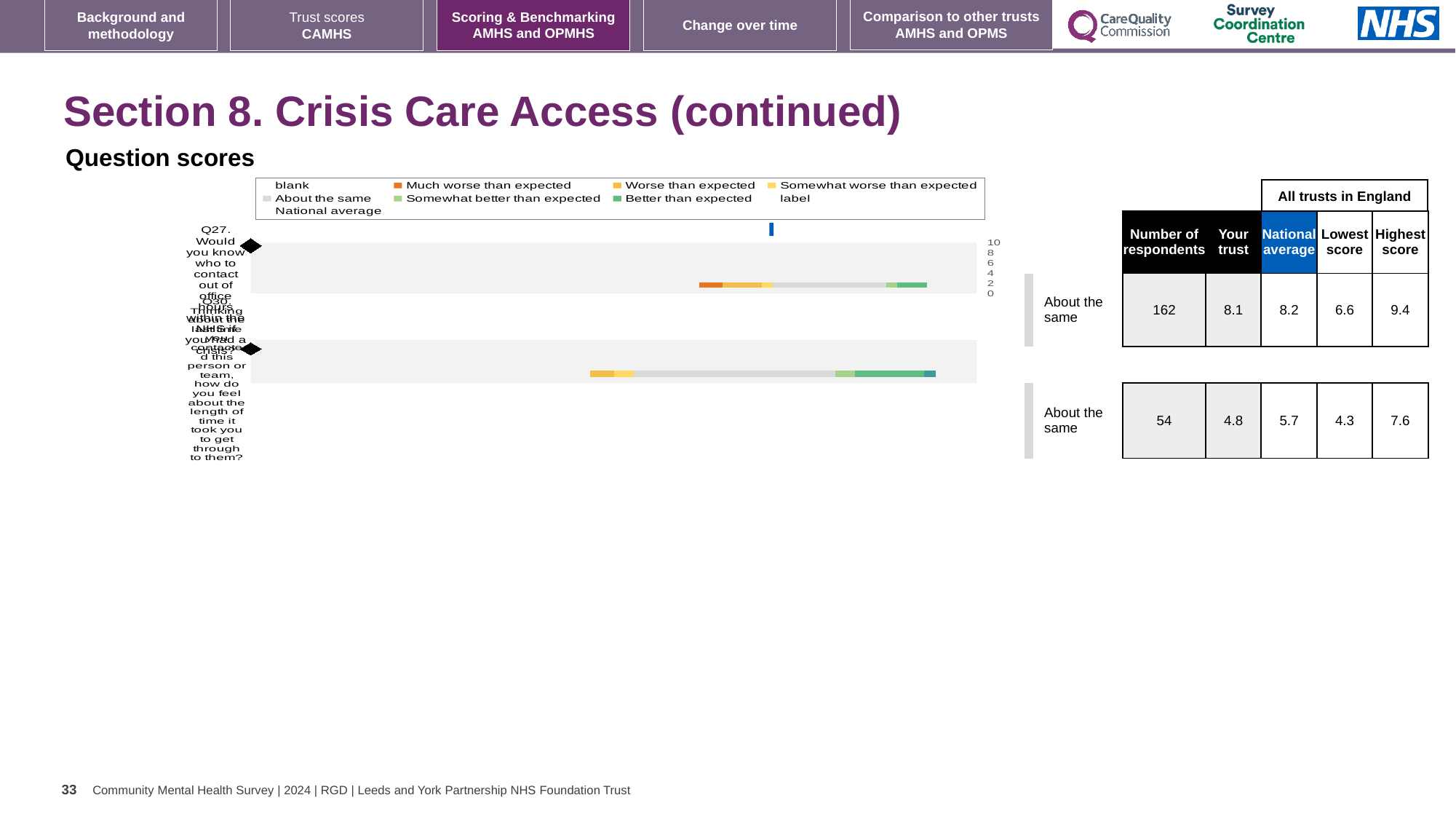
How many questions (bars) are plotted in the Question scores chart? 2 What benchmark category label is shown beside both Q27 and Q30? About the same What is the difference between the national average and the trust's score for Q30? 0.9 In the table next to the chart, what is the national average for Q30 (length of time it took to get through)? 5.7 How many respondents answered Q27 according to the table? 162 What is the lowest score across all trusts in England for Q30? 4.3 Which question has the higher 'Your trust' score, Q27 or Q30? Q27 How many entries does the legend of the Question scores chart list? 9 In the table next to the chart, what is the 'Your trust' score for Q27 (knowing who to contact out of office hours)? 8.1 What is the highest score across all trusts in England for Q27? 9.4 What kind of chart is shown under 'Question scores'? bar chart How many respondents answered Q30 according to the table? 54